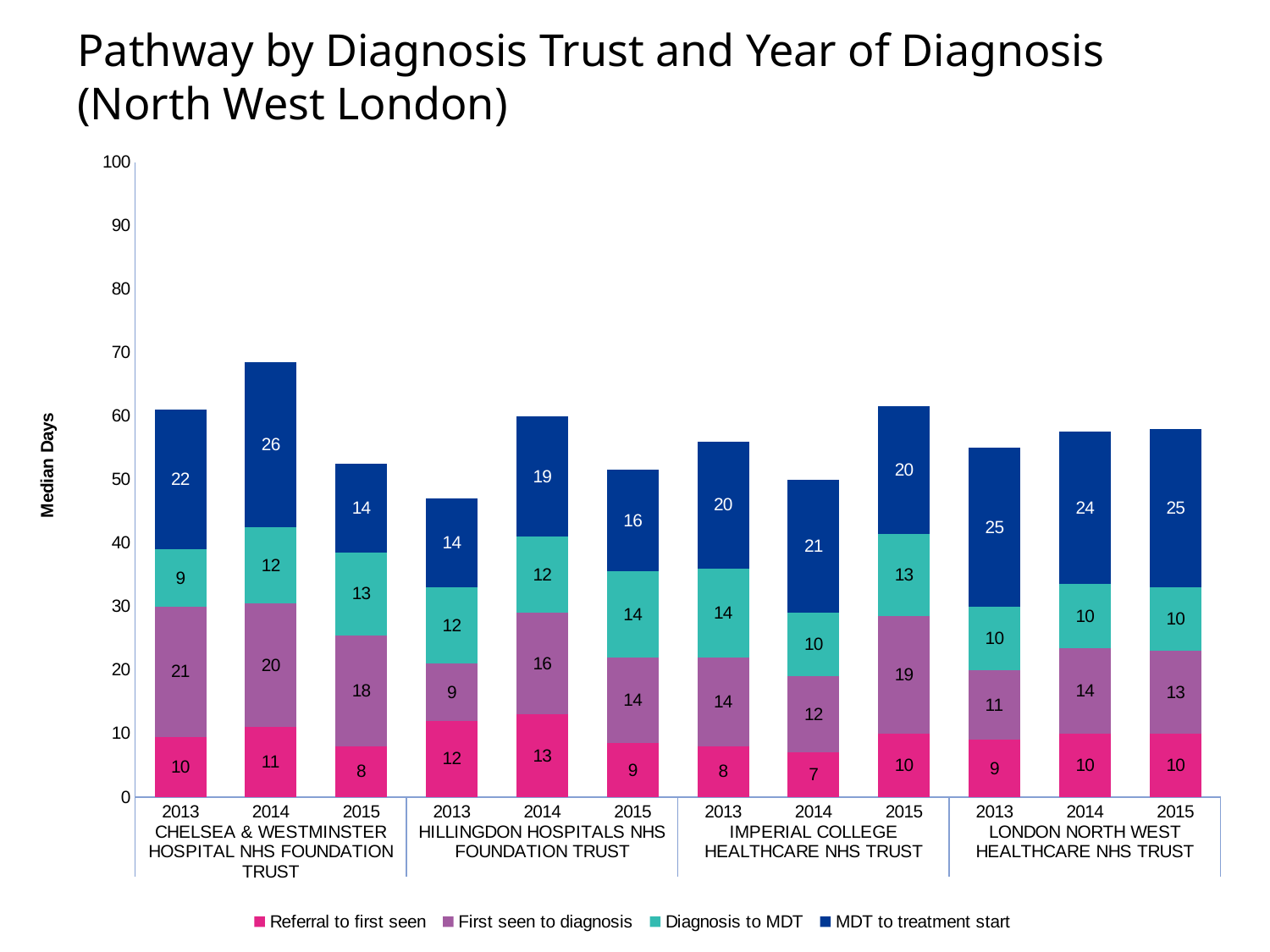
How many bars are plotted in the chart? 12 What is the 'MDT to treatment start' value for Chelsea & Westminster Hospital NHS Foundation Trust in 2014? 26 How many series does the legend list? 4 Which is larger: the 'First seen to diagnosis' value for Chelsea & Westminster in 2013 or for Imperial College Healthcare in 2015? Chelsea & Westminster 2013 What is the total median days for the Chelsea & Westminster Hospital NHS Foundation Trust 2014 bar? 69 What is the difference between the 'MDT to treatment start' values for London North West Healthcare NHS Trust in 2013 and 2014? 1 What is the total median days for the Hillingdon Hospitals NHS Foundation Trust 2013 bar? 47 What is the 'First seen to diagnosis' value for Hillingdon Hospitals NHS Foundation Trust in 2013? 9 Which bar has the lowest total median days? Hillingdon Hospitals NHS Foundation Trust 2013 Which bar has the highest total median days? Chelsea & Westminster Hospital NHS Foundation Trust 2014 What is the 'Referral to first seen' value for Imperial College Healthcare NHS Trust in 2014? 7 What kind of chart is shown on the slide? Stacked bar chart